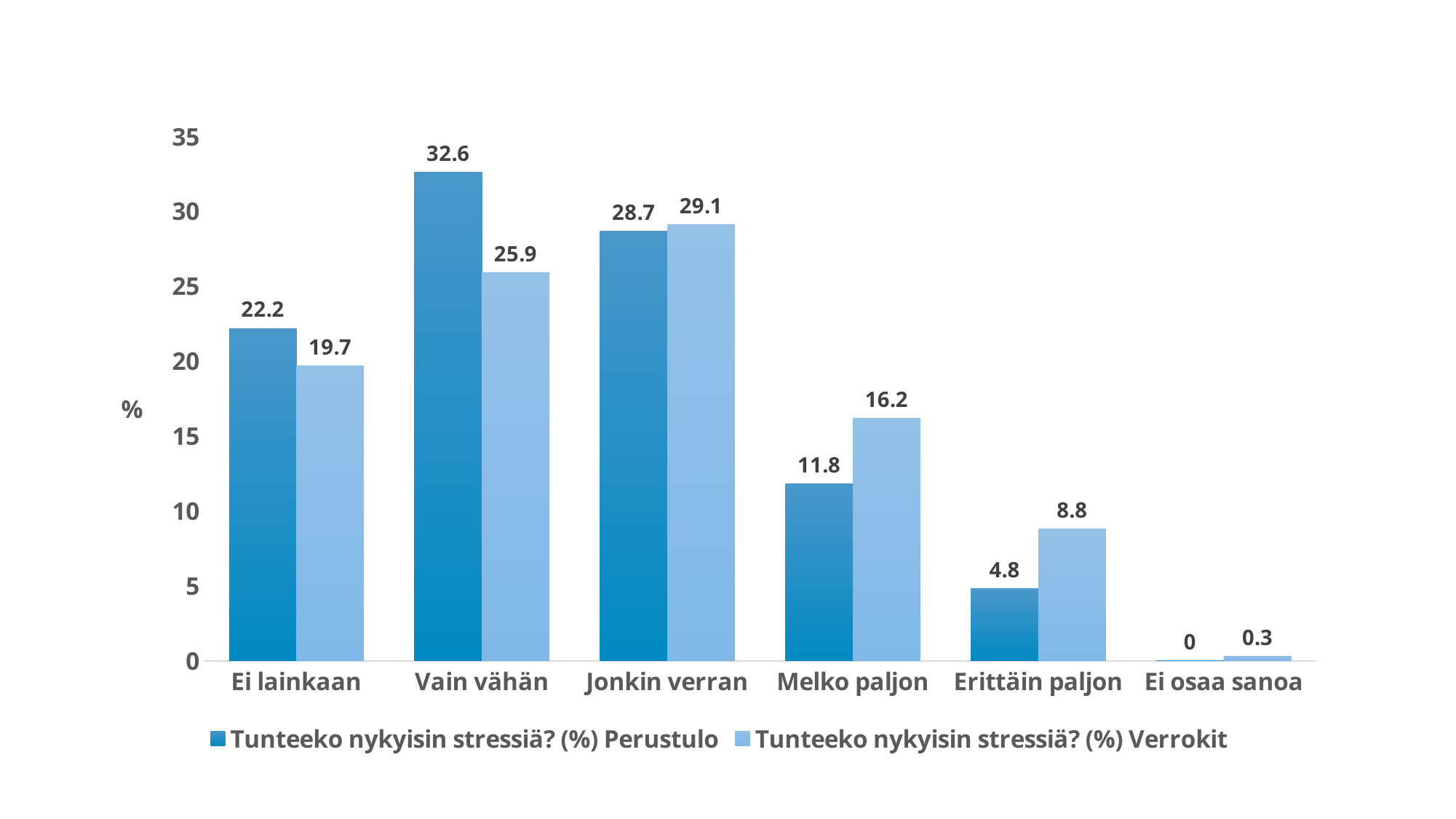
How many series does the legend list? 2 For Ei lainkaan, which series has the larger value, Perustulo or Verrokit? Perustulo Which category has the lowest Verrokit value? Ei osaa sanoa How many categories are shown on the x axis? 6 What is the Verrokit value for Melko paljon? 16.2 What is the Perustulo value for Vain vähän? 32.6 What is the Perustulo value for Erittäin paljon? 4.8 What kind of chart is shown on the slide? Bar chart What is the difference between the Verrokit and Perustulo values for Melko paljon? 4.4 For Erittäin paljon, which series has the larger value, Perustulo or Verrokit? Verrokit What is the difference between the Perustulo and Verrokit values for Vain vähän? 6.7 Which category has the highest Perustulo value? Vain vähän